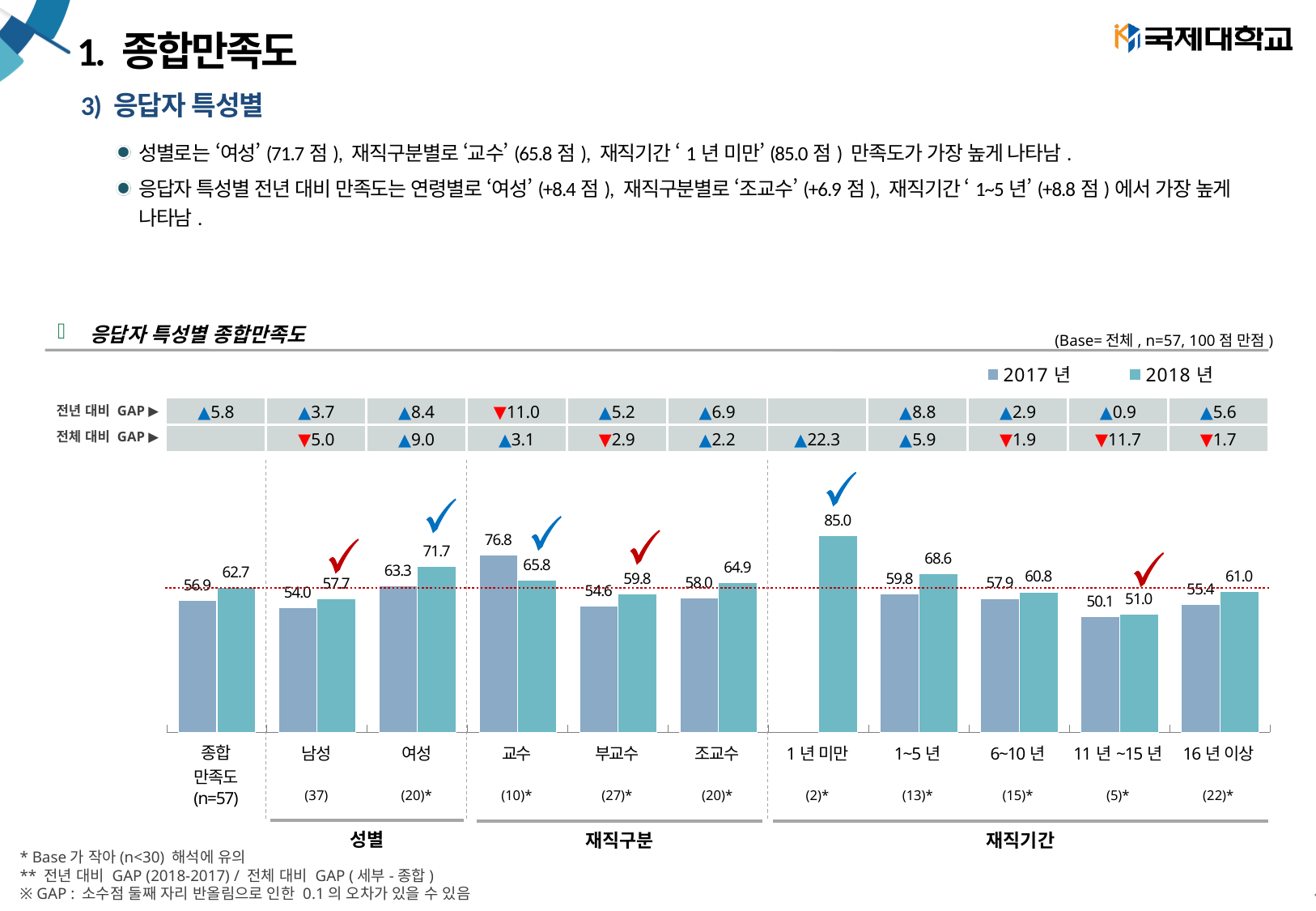
What is the title of the chart? 응답자 특성별 종합만족도 What is the difference between the 2018 년 and 2017 년 values for 종합만족도 (n=57)? 5.8 Which category has the highest 2018 년 value? 1 년 미만 What is the 2018 년 value for 1 년 미만? 85.0 What is the 2017 년 value for 부교수? 54.6 What is the 2018 년 value for 여성? 71.7 What kind of chart is shown on the slide? bar chart How many series does the legend list? 2 For 교수, which is larger: the 2017 년 value or the 2018 년 value? 2017 년 Which category has the lowest 2017 년 value? 11 년 ~15 년 What is the 2017 년 value for 교수? 76.8 How many categories are shown along the x axis of the chart? 11